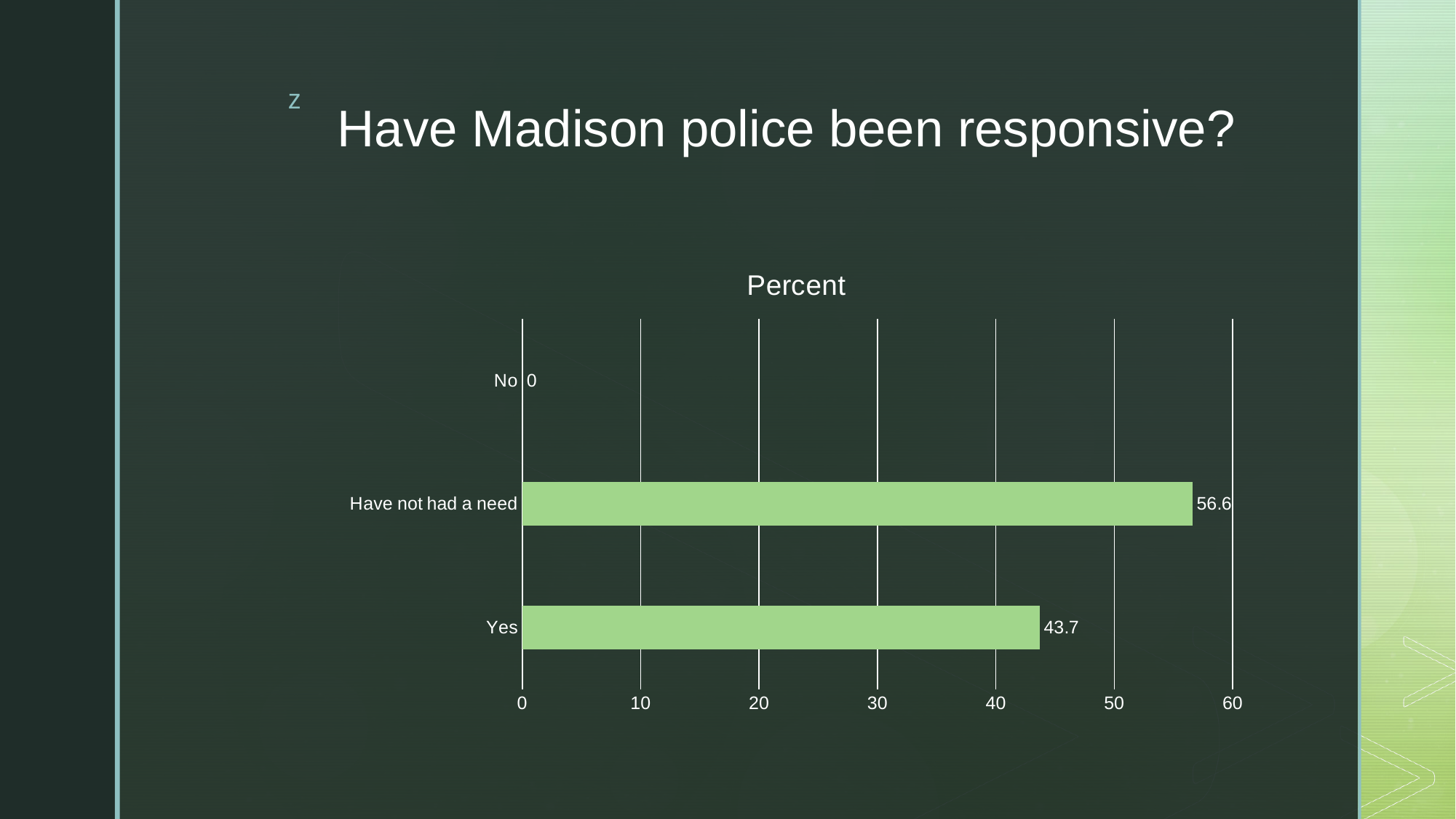
What is the value for "Yes"? 43.7 Which category has the lowest value? No How many categories are shown in the chart? 3 Is the value for "Yes" greater or less than 50? less What is the maximum value shown on the horizontal axis? 60 What is the value for "No"? 0 Which is larger, the value for "Yes" or the value for "Have not had a need"? Have not had a need What is the value for "Have not had a need"? 56.6 What kind of chart is shown on the slide? bar chart Which category has the highest value? Have not had a need What is the difference between the values for "Have not had a need" and "Yes"? 12.9 What is the title of the chart? Percent